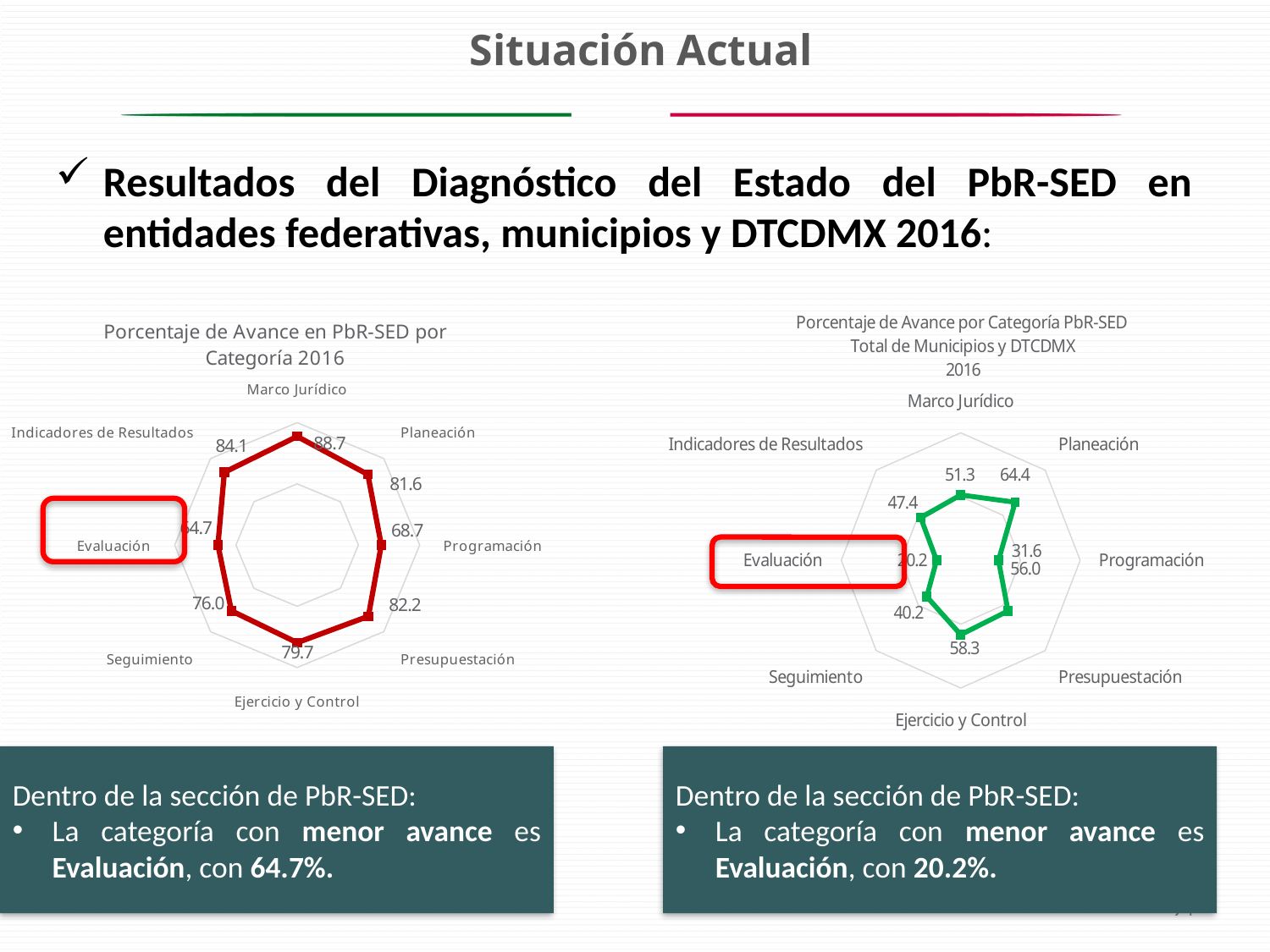
In the right chart, 'Porcentaje de Avance por Categoría PbR-SED Total de Municipios y DTCDMX 2016', what is the value for Ejercicio y Control? 58.3 In the left chart, 'Porcentaje de Avance en PbR-SED por Categoría 2016', what is the difference between Presupuestación and Seguimiento? 6.2 What kind of chart is the left chart, 'Porcentaje de Avance en PbR-SED por Categoría 2016'? Radar chart How many categories are plotted in the left chart, 'Porcentaje de Avance en PbR-SED por Categoría 2016'? 8 In the left chart, 'Porcentaje de Avance en PbR-SED por Categoría 2016', which category has the highest value? Marco Jurídico In the right chart, 'Porcentaje de Avance por Categoría PbR-SED Total de Municipios y DTCDMX 2016', what is the difference between Planeación and Indicadores de Resultados? 17.0 In the left chart, 'Porcentaje de Avance en PbR-SED por Categoría 2016', what is the value for Programación? 68.7 In the right chart, 'Porcentaje de Avance por Categoría PbR-SED Total de Municipios y DTCDMX 2016', what is the value for Evaluación? 20.2 In the right chart, 'Porcentaje de Avance por Categoría PbR-SED Total de Municipios y DTCDMX 2016', which is larger, Marco Jurídico or Seguimiento? Marco Jurídico In the left chart, 'Porcentaje de Avance en PbR-SED por Categoría 2016', what is the value for Marco Jurídico? 88.7 In the left chart, 'Porcentaje de Avance en PbR-SED por Categoría 2016', which category has the lowest value? Evaluación In the right chart, 'Porcentaje de Avance por Categoría PbR-SED Total de Municipios y DTCDMX 2016', which category has the highest value? Planeación